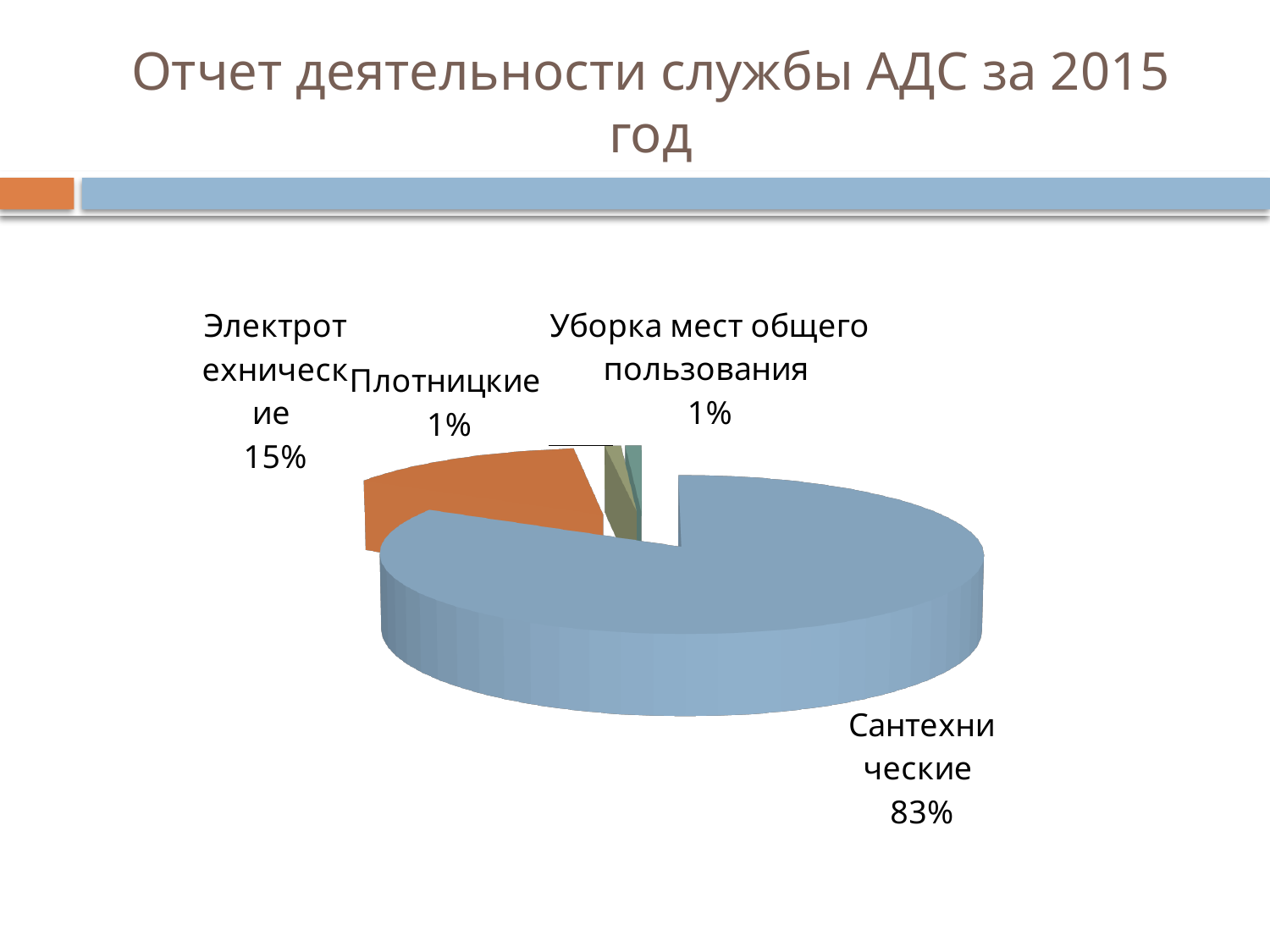
What is the difference in percentage points between the Сантехнические and Электротехнические slices? 68 What kind of chart is shown on the slide? Pie chart Is the share for Сантехнические greater or less than 50%? greater What share of the pie does the Электротехнические slice represent? 15% Which category has the largest slice of the pie? Сантехнические What share of the pie does the Уборка мест общего пользования slice represent? 1% What is the title of the slide containing the chart? Отчет деятельности службы АДС за 2015 год How many slices does the pie chart have? 4 Which is larger, the Электротехнические slice or the Плотницкие slice? Электротехнические What colour is the Сантехнические slice? Blue What share of the pie does the Плотницкие slice represent? 1%